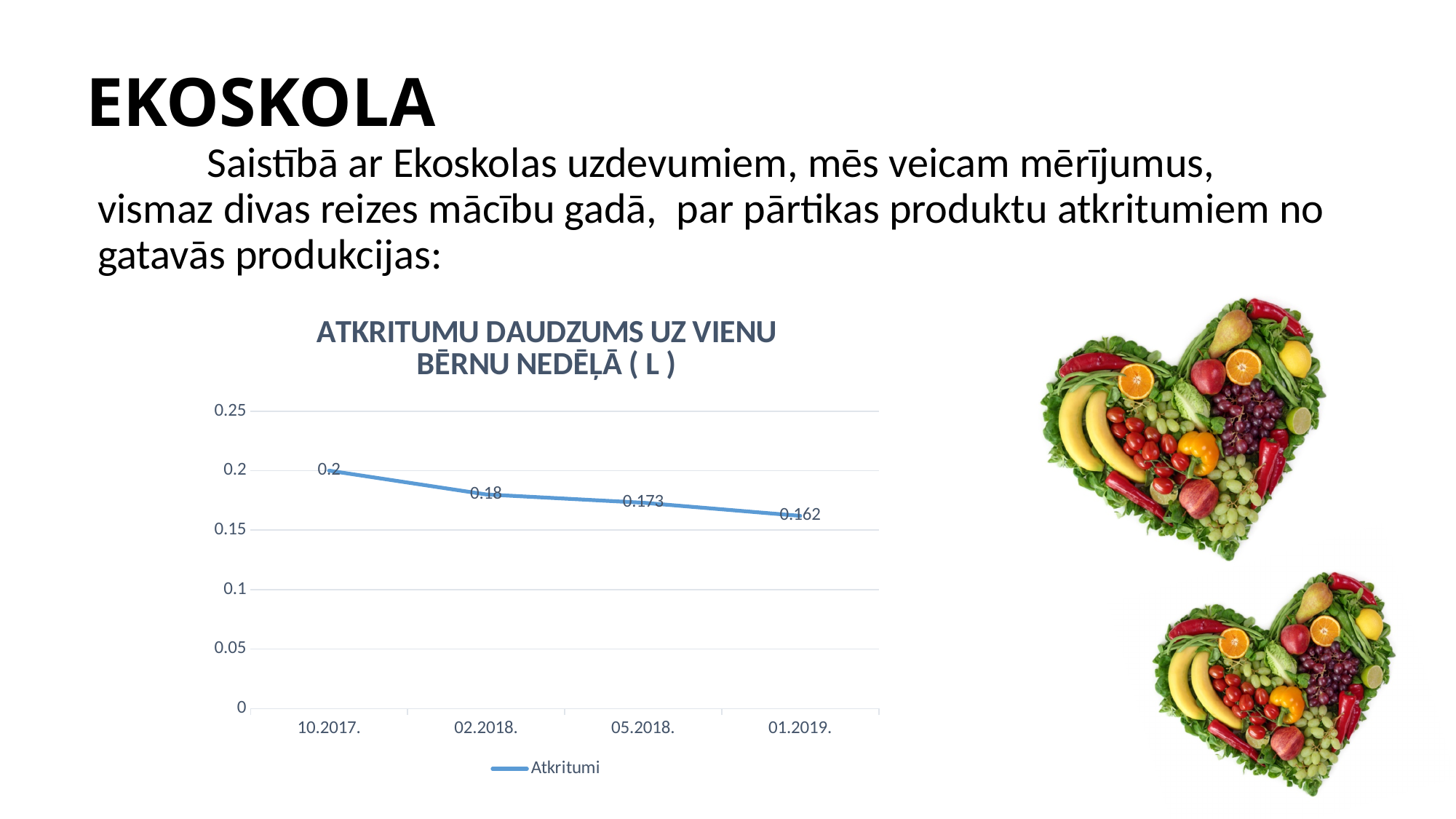
Do the values rise or fall from 10.2017. to 01.2019.? fall What is the value for 10.2017.? 0.2 Which is larger, the value for 02.2018. or the value for 05.2018.? 02.2018. Which period has the lowest value? 01.2019. How many data points are plotted on the chart? 4 What is the value for 02.2018.? 0.18 What is the difference between the values for 10.2017. and 01.2019.? 0.038 Is the value for 01.2019. greater or less than 0.15? greater What is the value for 01.2019.? 0.162 Which period has the highest value? 10.2017. What kind of chart is shown on the slide? line chart What is the value for 05.2018.? 0.173